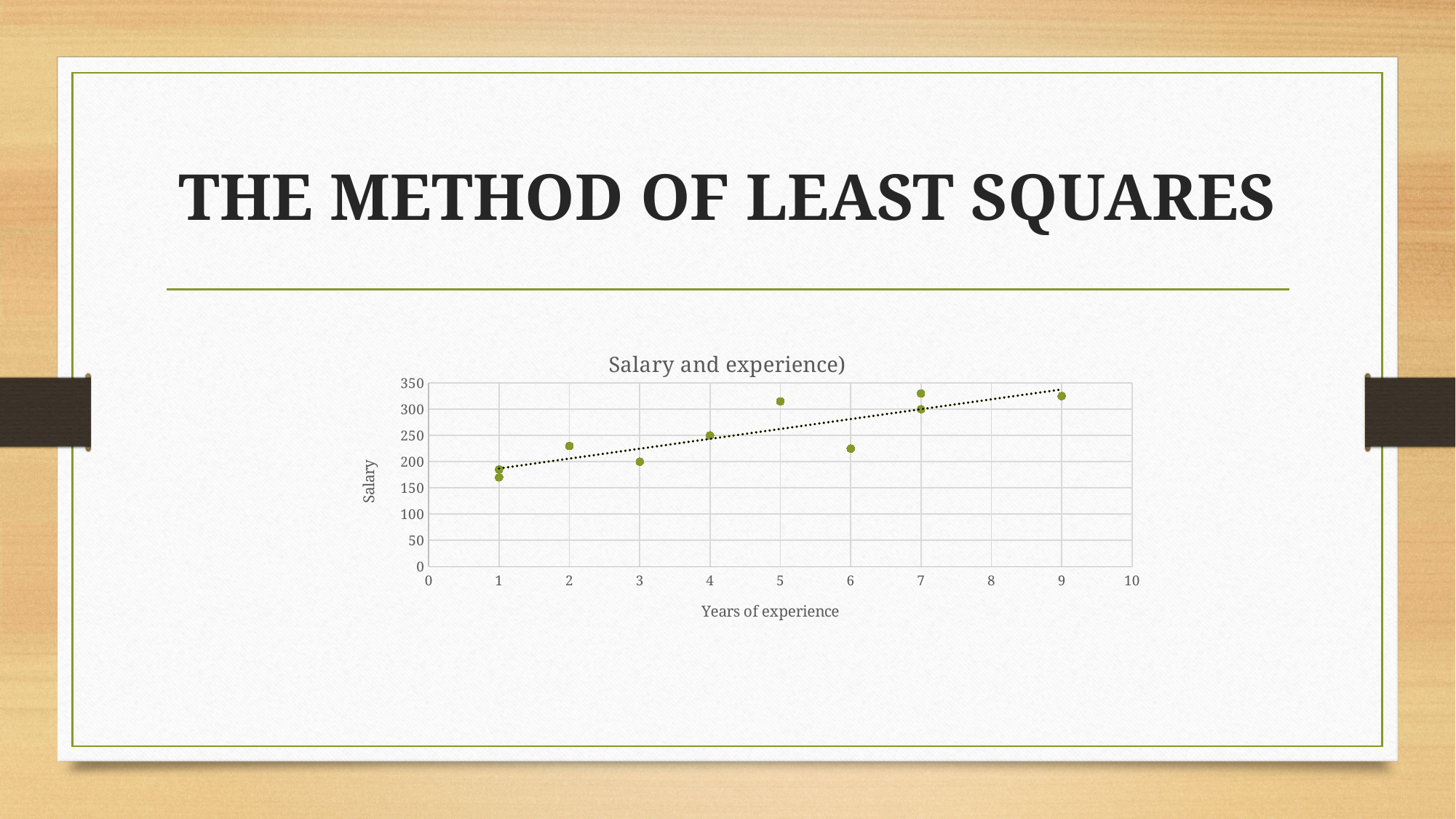
What is the label of the horizontal axis of the chart? Years of experience How many data points are plotted on the chart? 10 What is the salary value for the point at 4 years of experience? 250 What is the salary value for the point at 3 years of experience? 200 What kind of chart is shown on the slide? Scatter chart Which point has the lowest salary: the lowest point at 1 year of experience or the point at 3 years of experience? The lowest point at 1 year of experience What is the title of the chart? Salary and experience) Is the salary for the point at 5 years of experience greater or less than 300? greater Do the salary values generally rise or fall as years of experience increase? Rise Which has the higher salary: the point at 5 years of experience or the point at 6 years of experience? 5 years of experience Is the salary for the point at 6 years of experience greater or less than 250? less Is the salary for the point at 9 years of experience greater or less than 300? greater